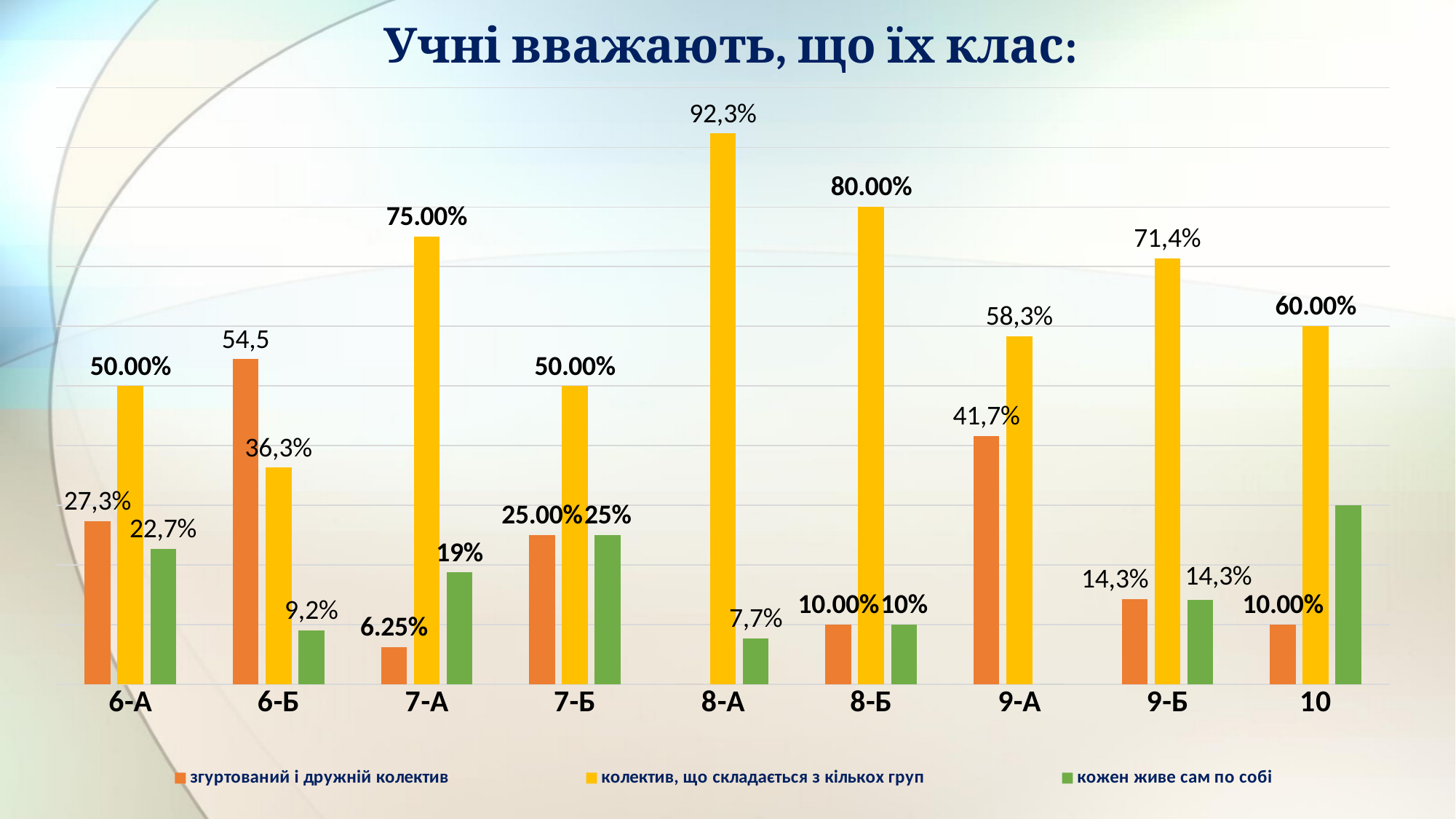
How many series does the legend list? 3 What is the value for "згуртований і дружній колектив" for class 6-Б? 54,5 Which colour represents "кожен живе сам по собі" in the legend? green How many classes are shown on the x axis? 9 For class 6-Б, which is larger: "згуртований і дружній колектив" or "колектив, що складається з кількох груп"? згуртований і дружній колектив Which class has the lowest labelled value for "згуртований і дружній колектив"? 7-А Which class has the highest value for "колектив, що складається з кількох груп"? 8-А What is the value for "колектив, що складається з кількох груп" for class 9-Б? 71,4% What kind of chart is shown on the slide? bar chart What is the value for "колектив, що складається з кількох груп" for class 8-А? 92,3% What is the value for "кожен живе сам по собі" for class 7-А? 19% For class 9-А, what is the difference between "колектив, що складається з кількох груп" and "згуртований і дружній колектив"? 16,6%